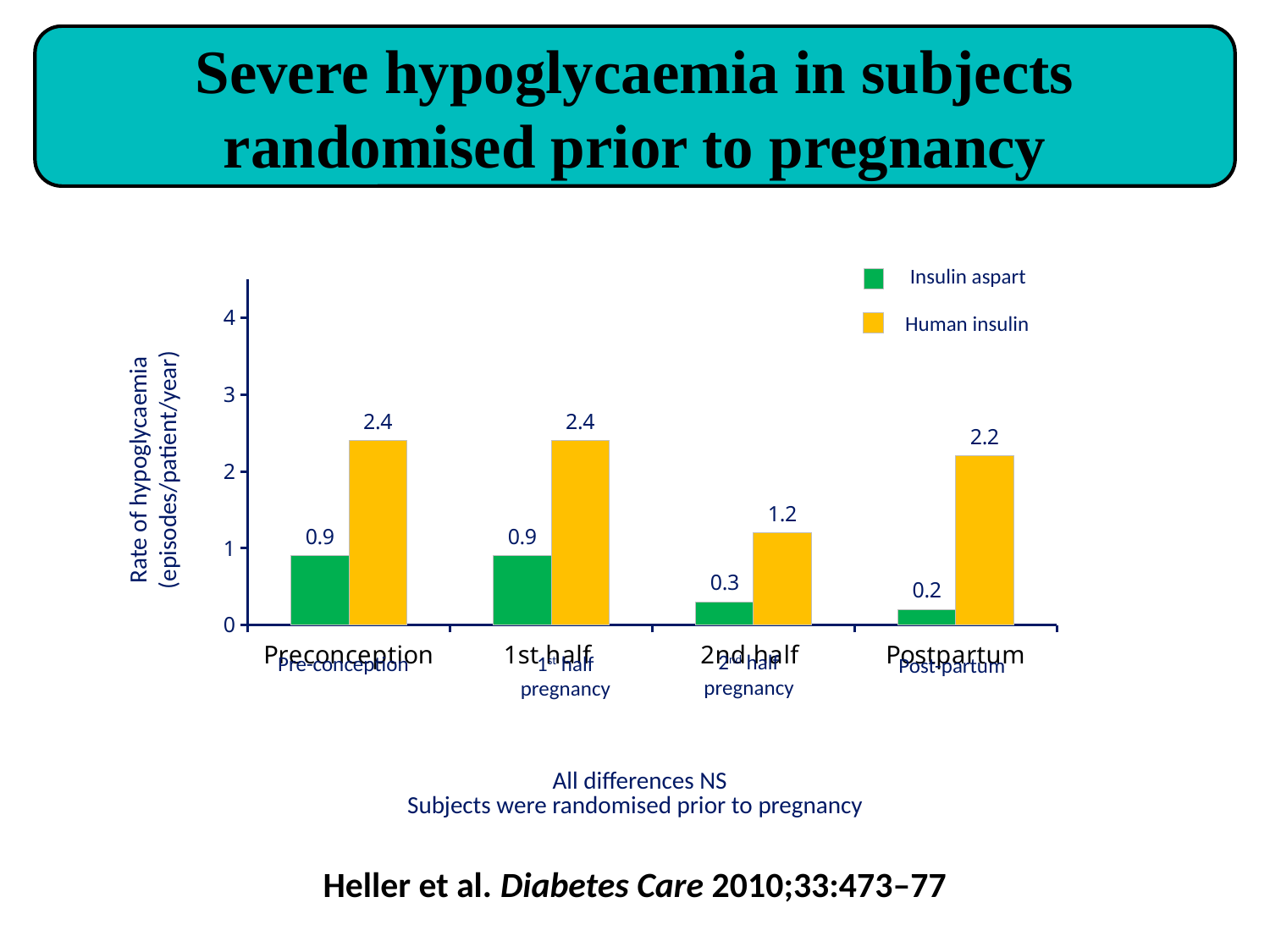
What type of chart is shown on the slide? Bar chart What is the rate of severe hypoglycaemia for Insulin aspart at Preconception? 0.9 How many series does the legend list? 2 What is the difference between the Human insulin and Insulin aspart rates at Preconception? 1.5 In which period is the Human insulin rate of hypoglycaemia lowest? 2nd half In which period is the Insulin aspart rate of hypoglycaemia lowest? Postpartum What is the difference between the Human insulin and Insulin aspart rates at Postpartum? 2.0 What is the rate of severe hypoglycaemia for Human insulin in the 2nd half of pregnancy? 1.2 Which series has the higher rate of hypoglycaemia in the 2nd half of pregnancy, Insulin aspart or Human insulin? Human insulin What is the rate of severe hypoglycaemia for Insulin aspart at Postpartum? 0.2 What is the rate of severe hypoglycaemia for Human insulin at Postpartum? 2.2 How many periods (categories) are shown on the x axis? 4